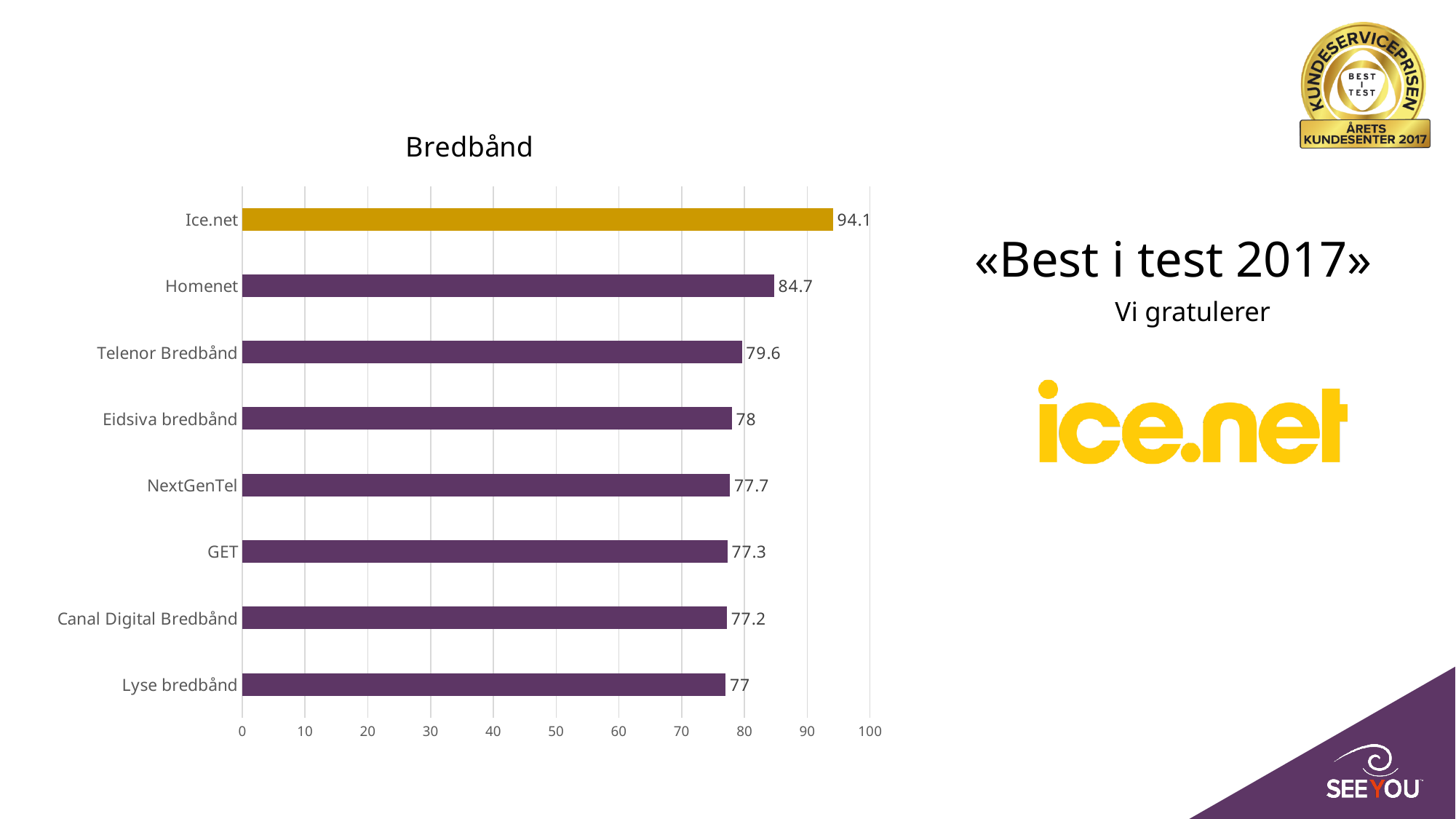
Which category has the lowest value? Lyse bredbånd Is the value for GET greater or less than 80? less What kind of chart is shown on the slide? bar chart How many categories are shown in the chart? 8 Which category has the highest value? Ice.net Which is larger, the value for Homenet or the value for Telenor Bredbånd? Homenet What is the title of the chart? Bredbånd What is the difference between the values for Ice.net and Homenet? 9.4 What is the value for Canal Digital Bredbånd? 77.2 What is the value for Ice.net? 94.1 What is the difference between the values for Eidsiva bredbånd and Lyse bredbånd? 1 What is the value for Telenor Bredbånd? 79.6